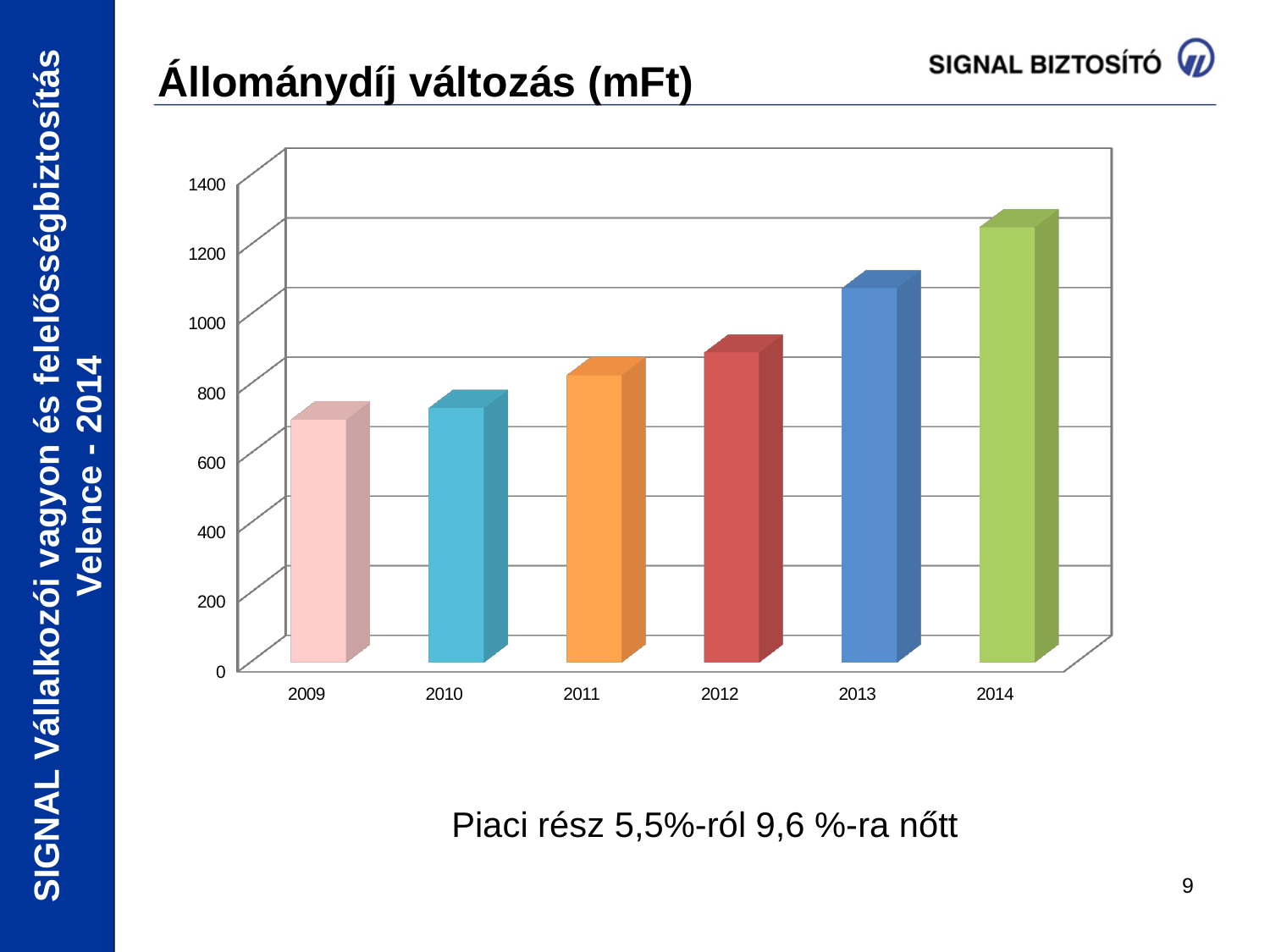
Is the value for 2014 greater or less than 1200? greater Is the value for 2011 greater or less than 1000? less What is the title of the chart? Állománydíj változás (mFt) Which year has the highest bar in the chart? 2014 Is the value for 2009 greater or less than 800? less How many years are shown on the x axis of the chart? 6 Which is larger, the value for 2012 or the value for 2013? 2013 Do the values rise or fall from 2009 to 2014? rise What colour is the bar for 2014? green What kind of chart is shown on the slide? bar chart